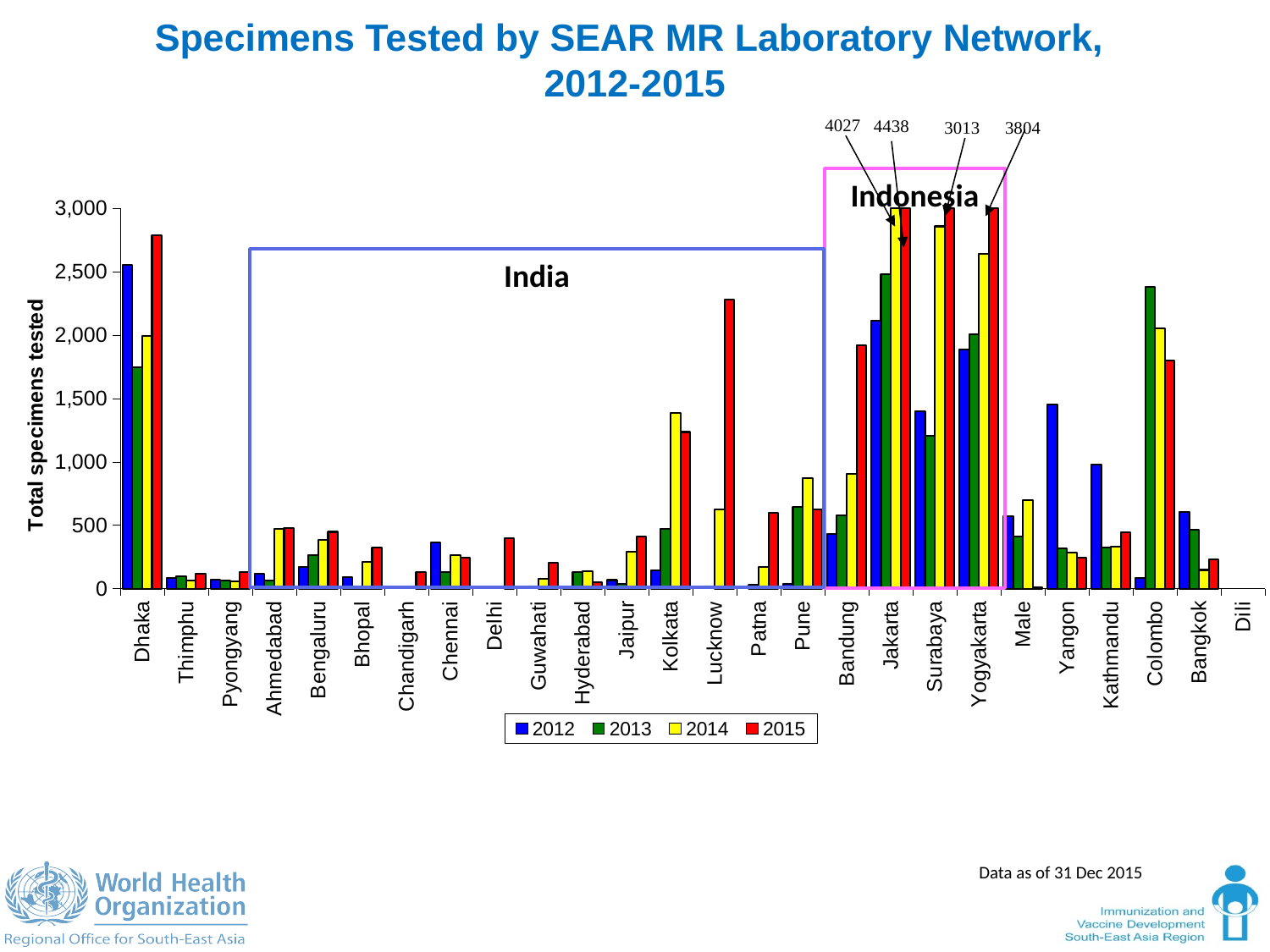
What is the largest value annotated above the chart for the Indonesia bars? 4438 Is the 2013 value for Colombo greater or less than 2,000? greater What is the label on the vertical axis? Total specimens tested Is the 2015 value for Delhi greater or less than 500? less For Dhaka, which is larger: the 2013 value or the 2015 value? 2015 Which city has the highest 2012 bar? Dhaka For 2015, which is larger: Lucknow or Kolkata? Lucknow What kind of chart is shown on the slide? bar chart How many cities are shown along the x axis? 26 Is the 2012 value for Dhaka greater or less than 2,500? greater How many series does the legend list? 4